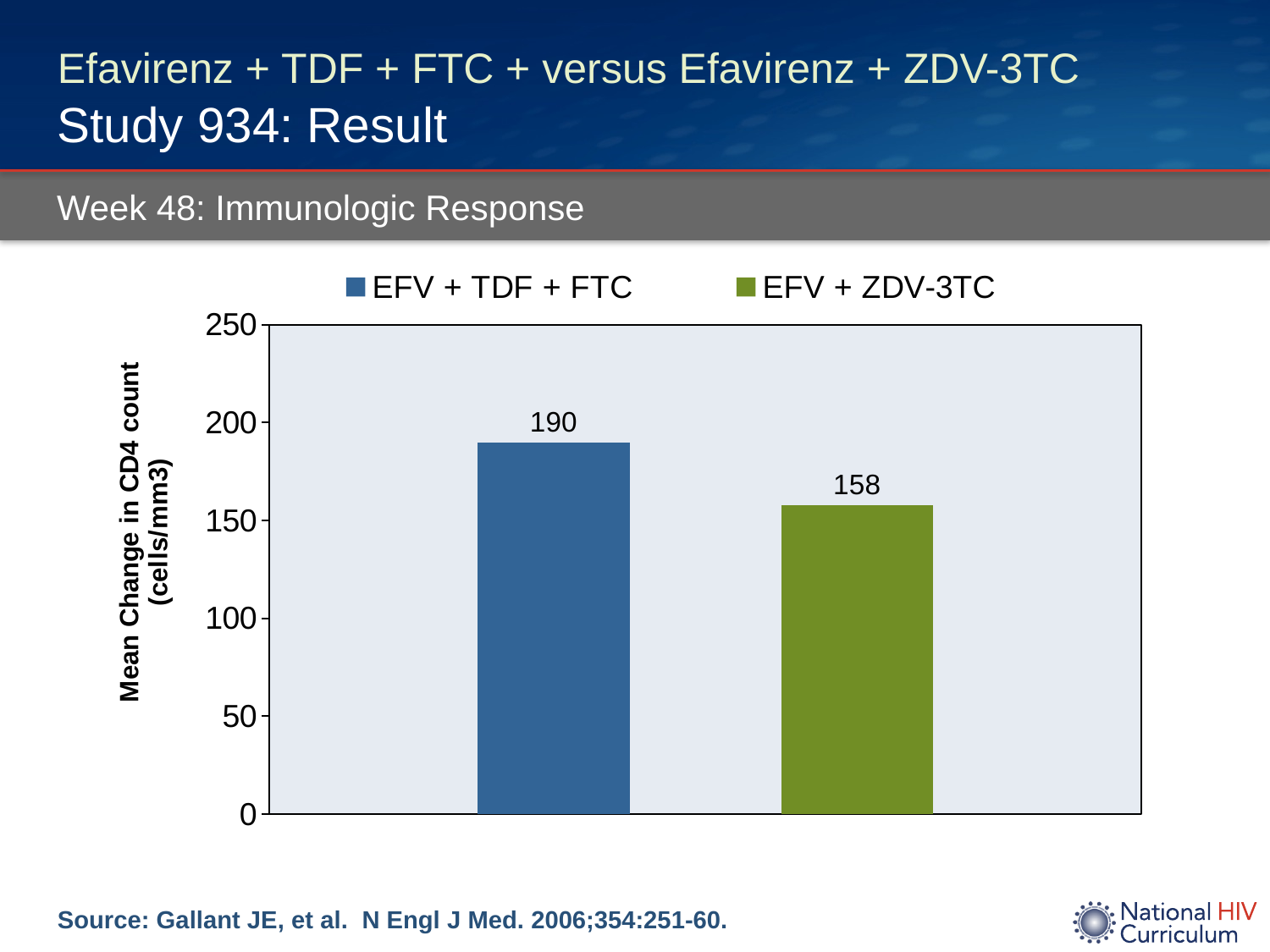
How many bars are plotted in the chart? 2 What is the difference in mean change in CD4 count between EFV + TDF + FTC and EFV + ZDV-3TC? 32 How many series does the legend list? 2 What is the mean change in CD4 count for EFV + TDF + FTC? 190 What kind of chart is shown on the slide? Bar chart Is the value for EFV + ZDV-3TC greater or less than 150? greater Which treatment arm has the lower mean change in CD4 count? EFV + ZDV-3TC Is the mean change in CD4 count larger for EFV + TDF + FTC or for EFV + ZDV-3TC? EFV + TDF + FTC Is the value for EFV + TDF + FTC greater or less than 200? less Which treatment arm has the higher mean change in CD4 count? EFV + TDF + FTC What is the mean change in CD4 count for EFV + ZDV-3TC? 158 What is the label of the y axis? Mean Change in CD4 count (cells/mm3)